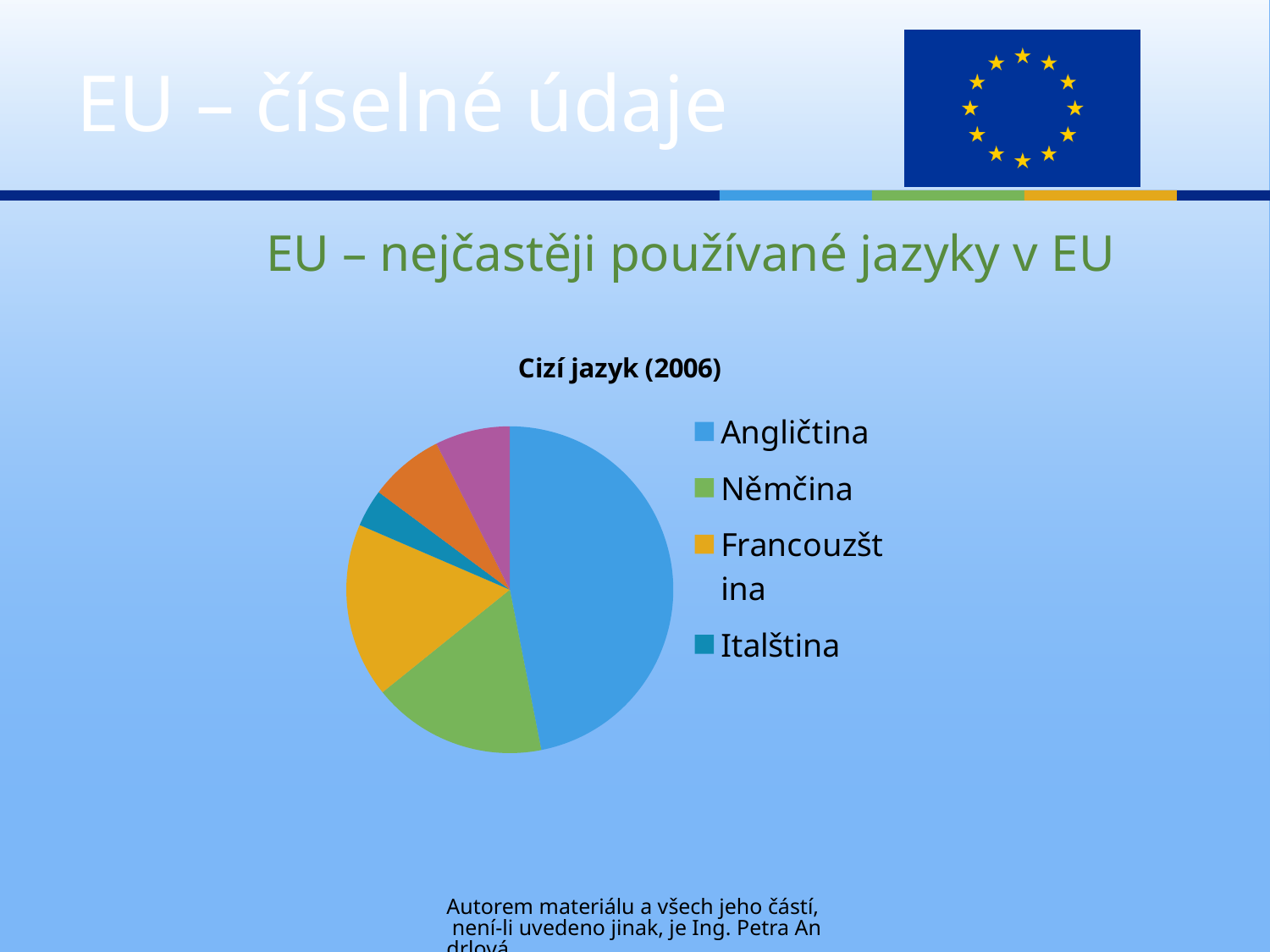
Which slice is larger, Angličtina or Francouzština? Angličtina What colour is the slice for Angličtina? blue How many slices does the pie chart have? 6 How many entries does the chart's legend list? 4 Which of the languages listed in the legend has the smallest slice? Italština What kind of chart is shown on the slide? pie chart Which slice is larger, Francouzština or Italština? Francouzština Which slice is larger, Němčina or Italština? Němčina Which language has the largest slice of the pie? Angličtina What is the title of the chart? Cizí jazyk (2006)